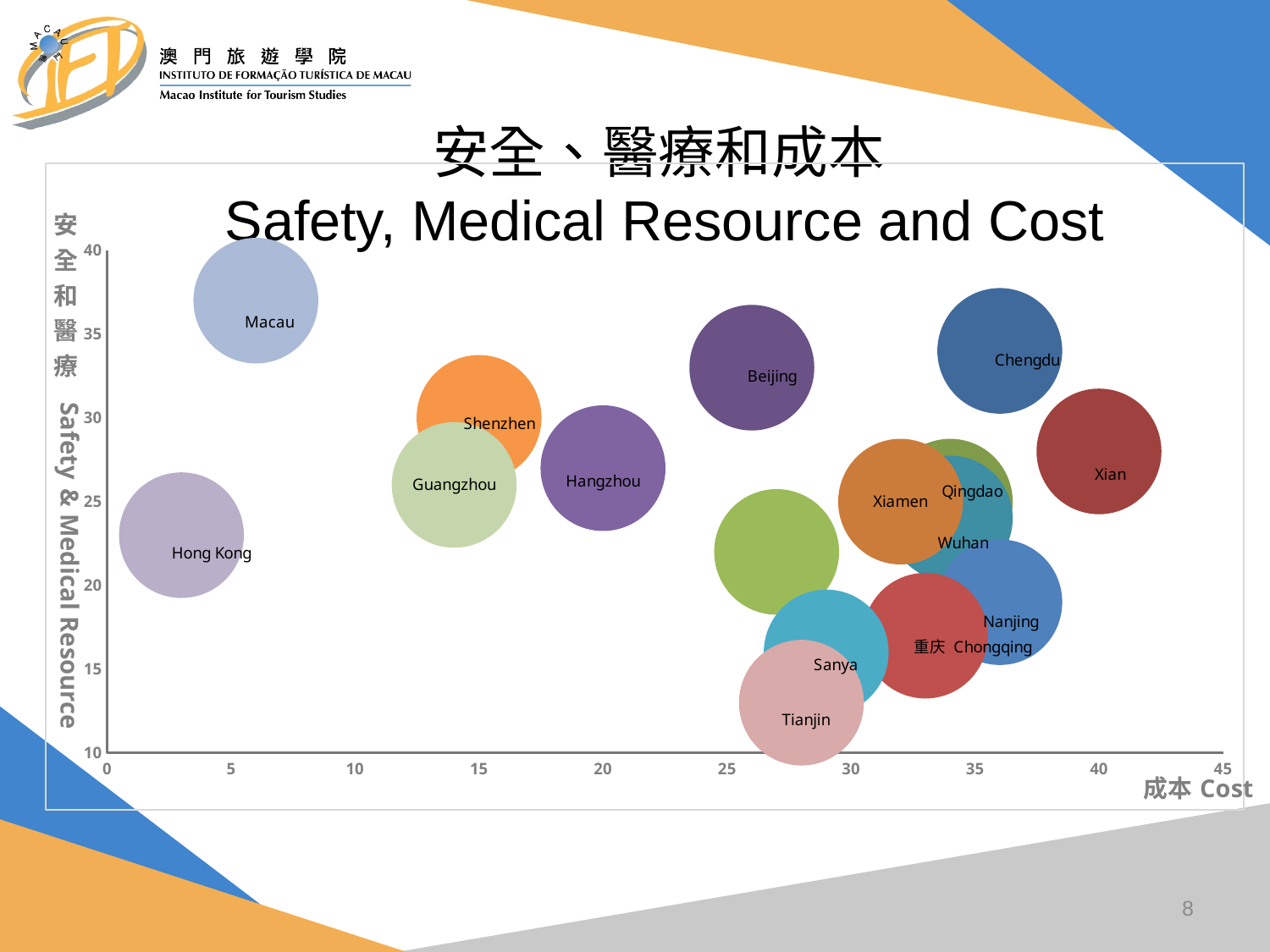
Which city has a higher Safety & Medical Resource value, Chengdu or Sanya? Chengdu What is the label of the horizontal axis of the chart? 成本 Cost Which city has the lowest Safety & Medical Resource value? Tianjin What kind of chart is shown on the slide? Bubble chart Is the Cost value for Macau greater or less than 10? less Which city has the highest Cost value? Xian What is the title of the chart on the slide (in English)? Safety, Medical Resource and Cost Which city has the highest Safety & Medical Resource value? Macau Is the Safety & Medical Resource value for Tianjin greater or less than 15? less Which city has the lowest Cost value? Hong Kong Is the Safety & Medical Resource value for Beijing greater or less than 30? greater Which city has a higher Cost value, Hong Kong or Hangzhou? Hangzhou